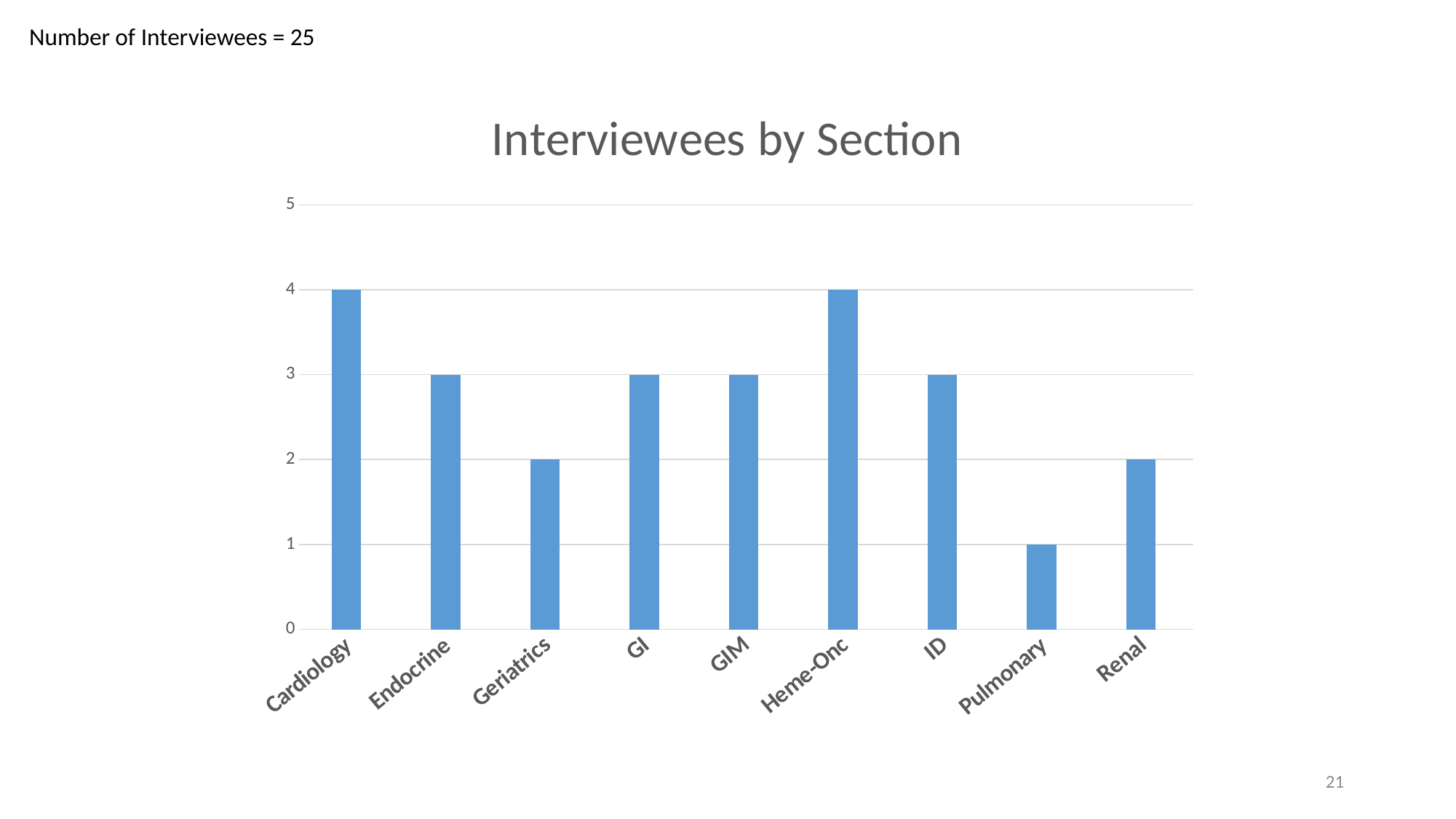
What kind of chart is this? bar chart How many sections are shown on the x axis? 9 Which is larger, the value for Endocrine or the value for Geriatrics? Endocrine What is the value for Cardiology? 4 What is the value for ID? 3 What is the title of the chart? Interviewees by Section Is the value for GIM greater or less than 2? greater Which section has the lowest number of interviewees? Pulmonary What is the highest value shown on the y axis? 5 What is the value for Geriatrics? 2 What is the value for Pulmonary? 1 What is the difference between the values for Heme-Onc and Renal? 2